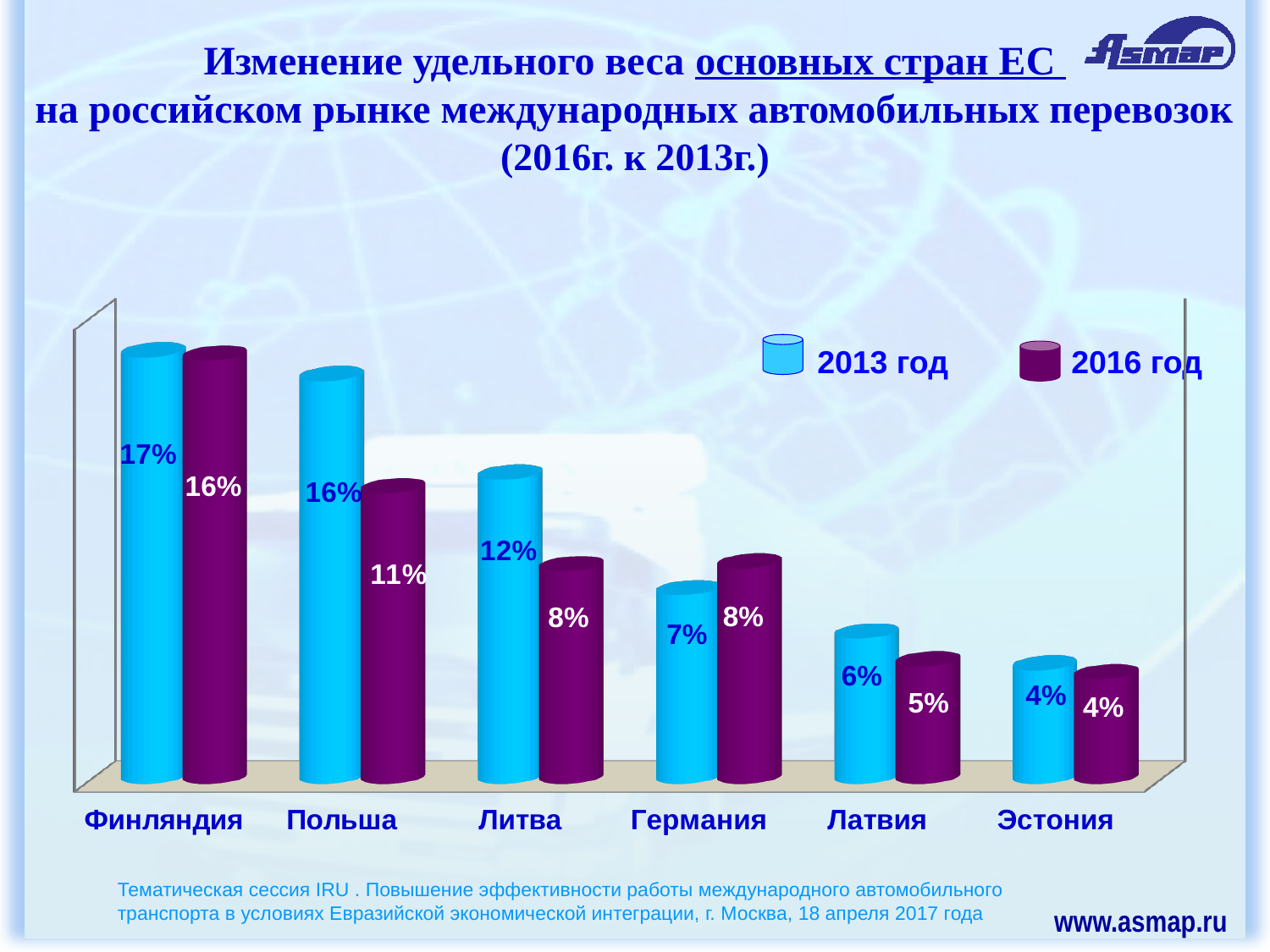
What kind of chart is shown on the slide? Bar chart How many series does the legend list? 2 How many countries are shown on the chart? 6 For Германия, which year has the larger share, 2013 год or 2016 год? 2016 год What was the share for Польша in 2016 год? 11% By how many percentage points did the share for Польша fall from 2013 год to 2016 год? 5 percentage points Which colour represents 2016 год in the legend? Purple What is the difference between the 2013 год and 2016 год values for Литва? 4 percentage points What was the share for Финляндия in 2013 год? 17% Which country had the highest share in 2013 год? Финляндия What was the share for Германия in 2016 год? 8% Which country had the lowest share in 2016 год? Эстония